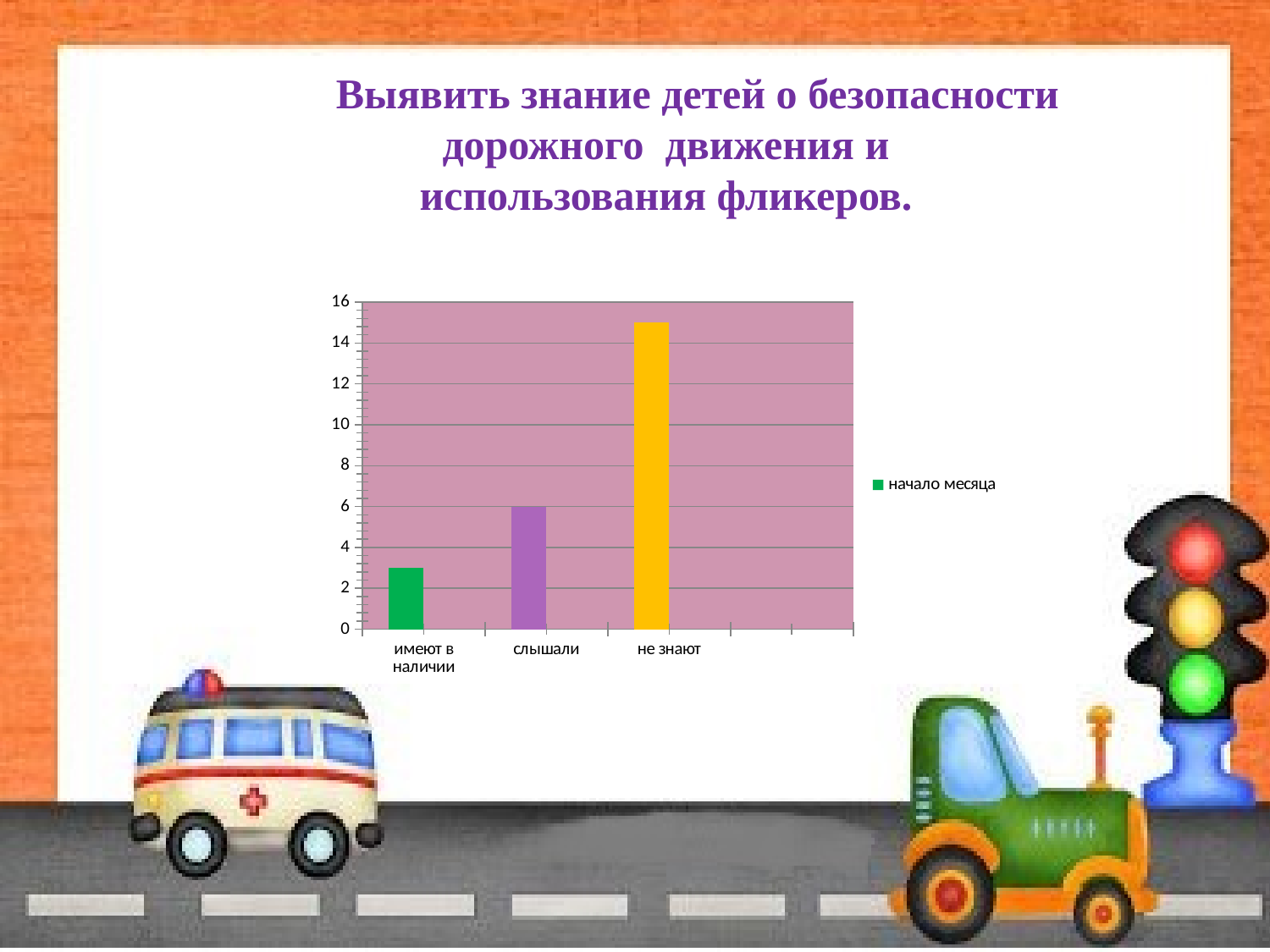
How many series does the chart legend list? 1 Which category has the highest bar in the chart? не знают Do the bar values rise or fall from left to right along the x axis? rise Is the value for "не знают" greater or less than 14? greater Which category has the lowest bar in the chart? имеют в наличии What is the value for "слышали" in the chart? 6 How many categories are shown on the x axis of the chart? 3 What kind of chart is shown on the slide? bar chart Which is larger, the value for "слышали" or the value for "не знают"? не знают What is the name of the series in the chart legend? начало месяца Is the value for "имеют в наличии" greater or less than 4? less What is the highest value shown on the vertical axis of the chart? 16